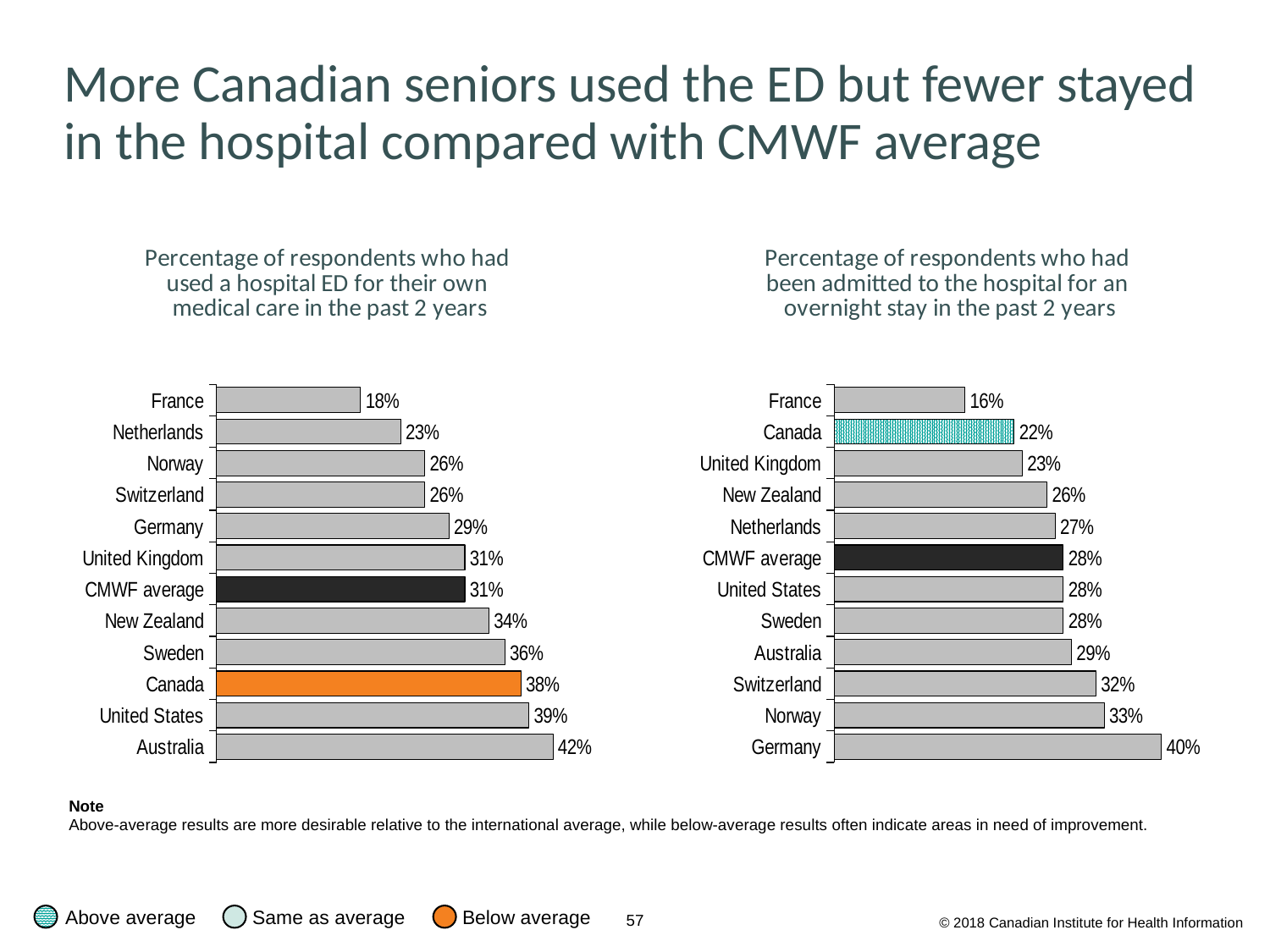
In the right chart (admitted to the hospital overnight), which country has the lowest value? France In the right chart (admitted to the hospital overnight), what is the value for Germany? 40% What kind of chart is the left chart (used a hospital ED)? Bar chart In the left chart (used a hospital ED), which country has the highest value? Australia In the right chart (admitted to the hospital overnight), what is the difference between Germany and France? 24% In the right chart (admitted to the hospital for an overnight stay), what is the value for Canada? 22% In the left chart (used a hospital ED), what is the difference between Canada and the CMWF average? 7% In the right chart (admitted to the hospital overnight), which is larger, the value for Norway or the value for Switzerland? Norway In the left chart (used a hospital ED), how many bars are shown? 12 In the left chart (used a hospital ED in the past 2 years), what is the value for Canada? 38% In the left chart (used a hospital ED), what colour is the bar for Canada? Orange In the left chart (used a hospital ED), what is the value for the CMWF average? 31%